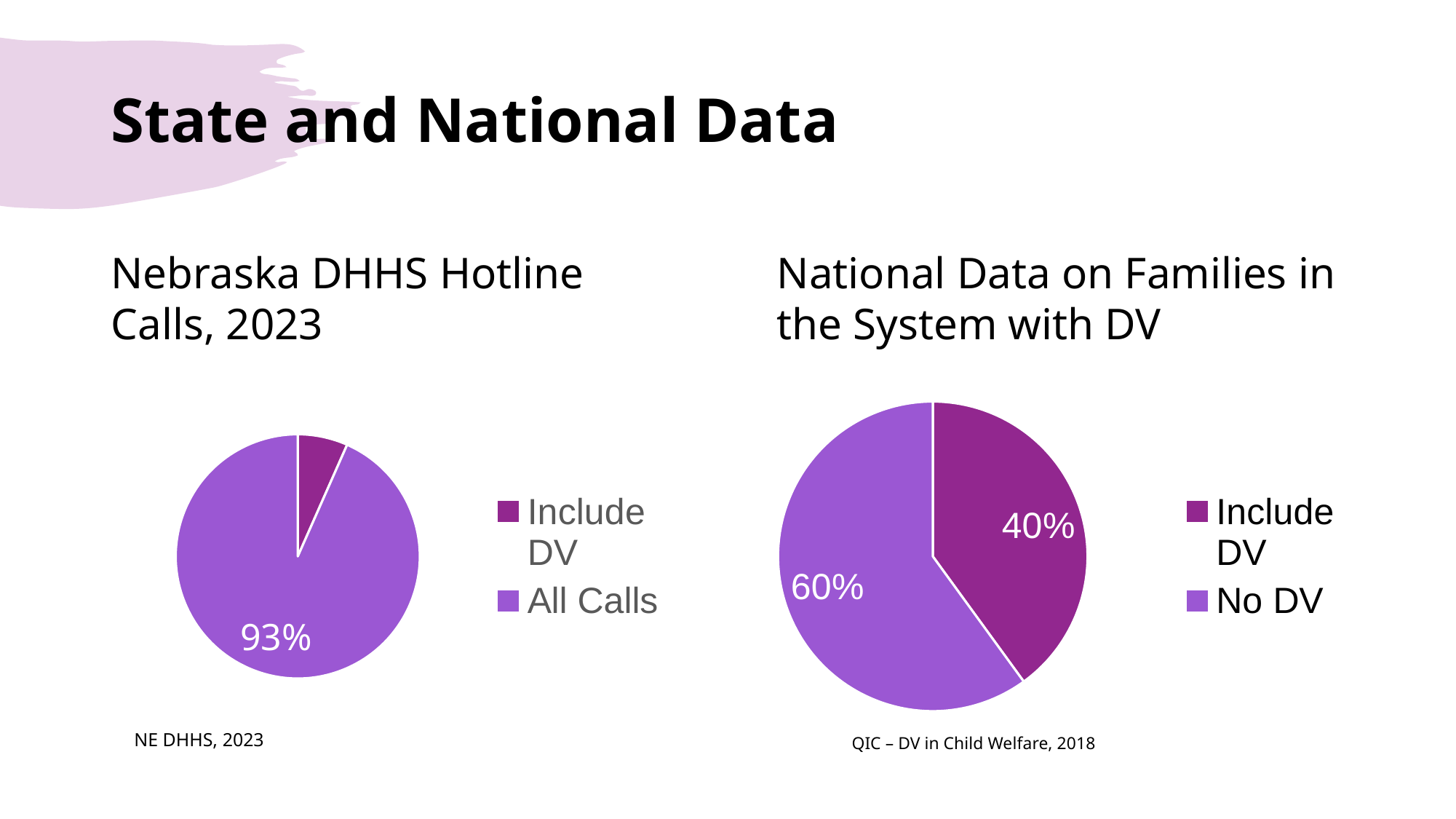
How many entries does the legend of the Nebraska DHHS Hotline Calls, 2023 chart list? 2 In the Nebraska DHHS Hotline Calls, 2023 chart, what share of the pie is All Calls? 93% In the Nebraska DHHS Hotline Calls, 2023 chart, which slice is larger, Include DV or All Calls? All Calls In the National Data on Families in the System with DV chart, what is the value for Include DV? 40% What type of chart is the Nebraska DHHS Hotline Calls, 2023 chart? pie chart What source is cited below the National Data on Families in the System with DV chart? QIC – DV in Child Welfare, 2018 In the National Data on Families in the System with DV chart, what is the difference between No DV and Include DV? 20% How many slices does the National Data on Families in the System with DV pie chart have? 2 In the Nebraska DHHS Hotline Calls, 2023 chart, which slice is the smallest? Include DV In the National Data on Families in the System with DV chart, which slice is the largest? No DV What type of chart is the National Data on Families in the System with DV chart? pie chart In the National Data on Families in the System with DV chart, what is the value for No DV? 60%